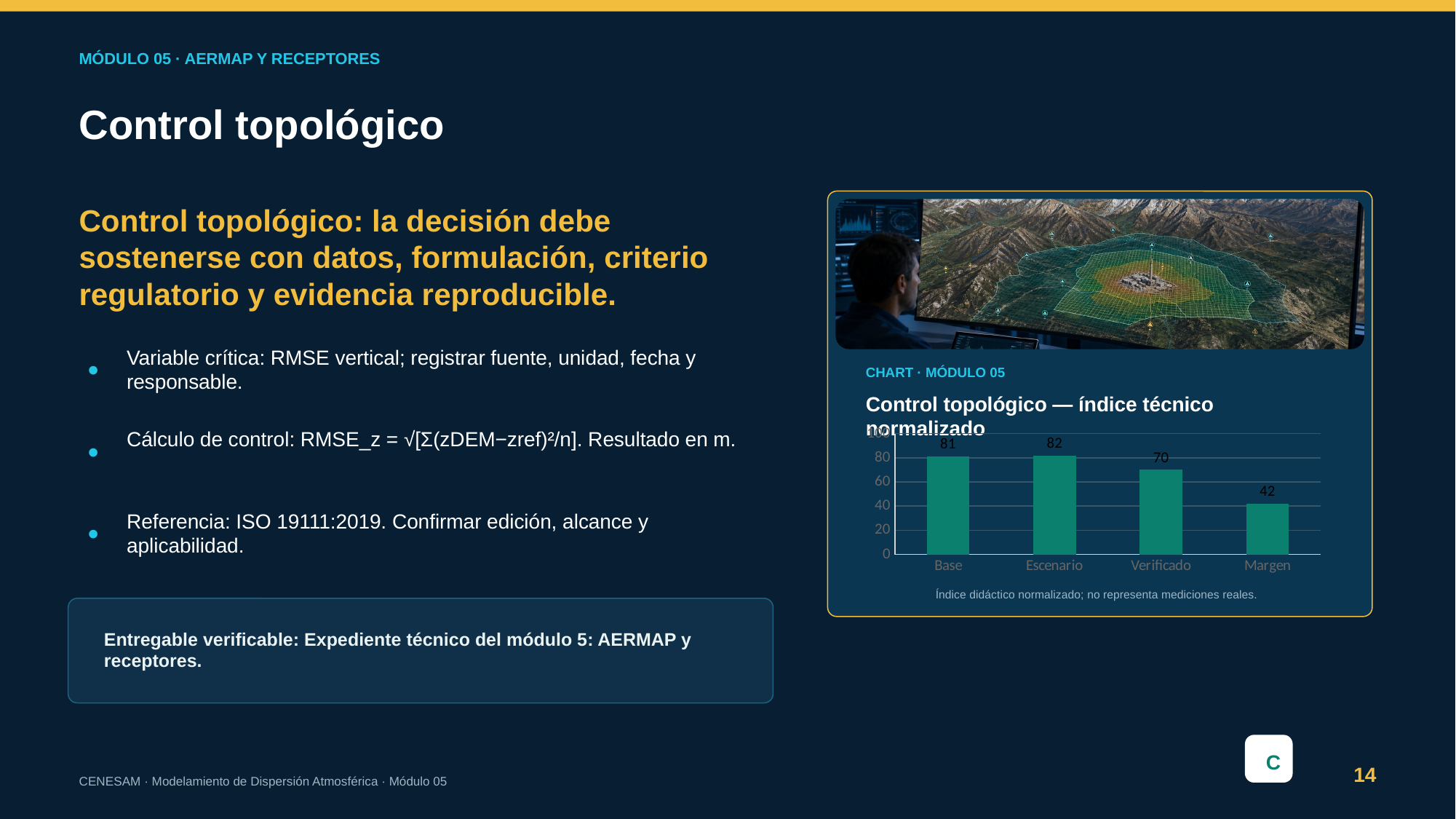
Which category has the lowest value? Margen What is the value for Verificado? 70 What is the title of the chart? Control topológico — índice técnico normalizado What kind of chart is shown? bar chart What is the value for Escenario? 82 Is the value for Verificado greater or less than 60? greater What is the value for Margen? 42 Which is larger, the value for Base or the value for Margen? Base What is the value for Base? 81 What is the difference between the values for Escenario and Base? 1 What is the difference between the values for Verificado and Margen? 28 How many categories are shown on the x axis? 4